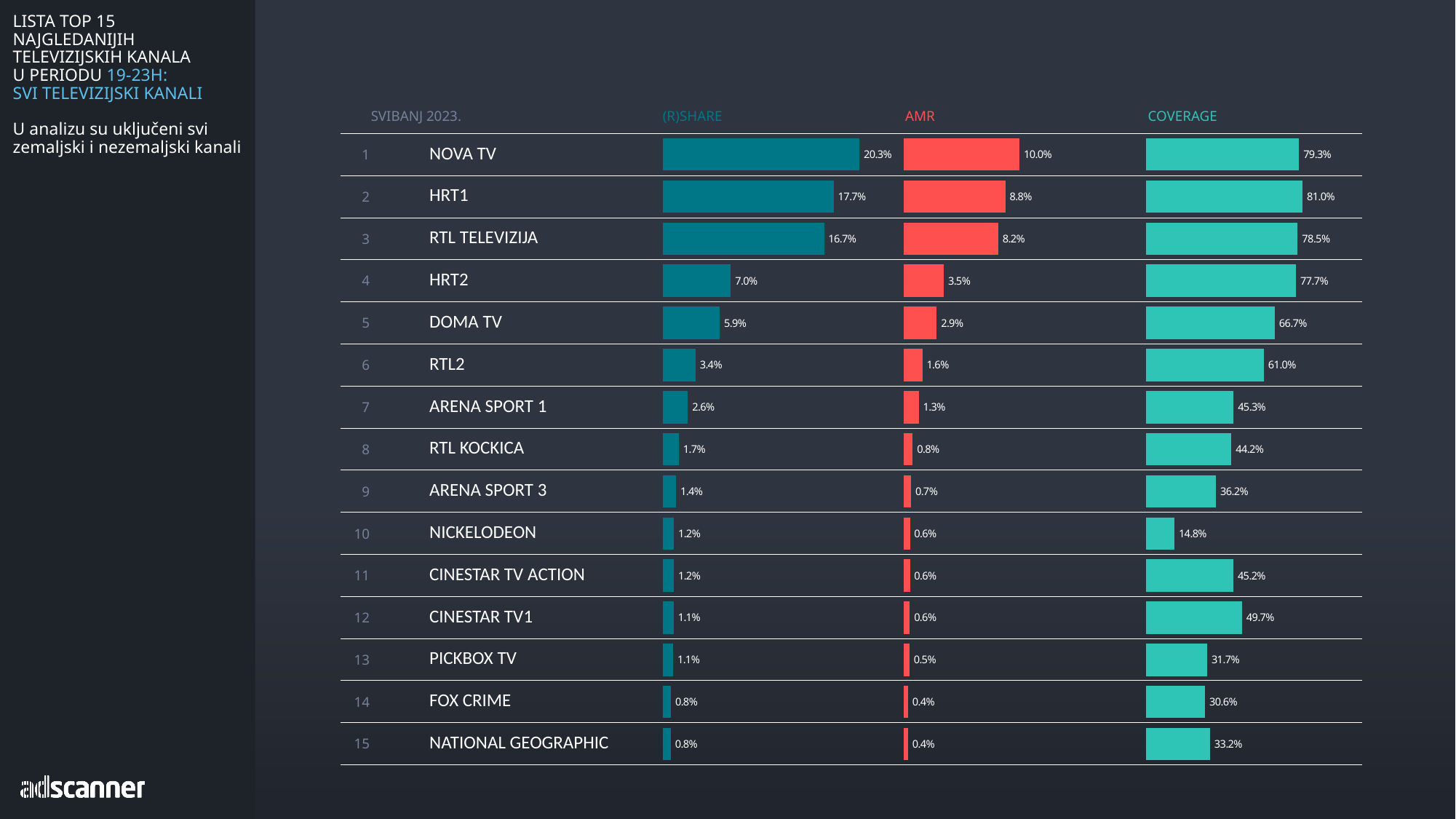
In the AMR column, what is the value for HRT1? 8.8% In the COVERAGE column, which channel has the highest value? HRT1 How many channels are listed in the table? 15 Do the (R)SHARE values rise or fall going down the list from rank 1 to rank 15? Fall In the AMR column, what is the difference between NOVA TV and RTL TELEVIZIJA? 1.8% In the (R)SHARE column, what is the difference between NOVA TV and HRT1? 2.6% In the COVERAGE column, what is the value for DOMA TV? 66.7% What kind of chart is used to show the (R)SHARE, AMR and COVERAGE values? Bar chart Which month and year does the table header indicate the data is for? SVIBANJ 2023. In the COVERAGE column, which is larger: RTL TELEVIZIJA or HRT2? RTL TELEVIZIJA In the (R)SHARE column, what is the value for NOVA TV? 20.3% In the COVERAGE column, which channel has the lowest value? NICKELODEON